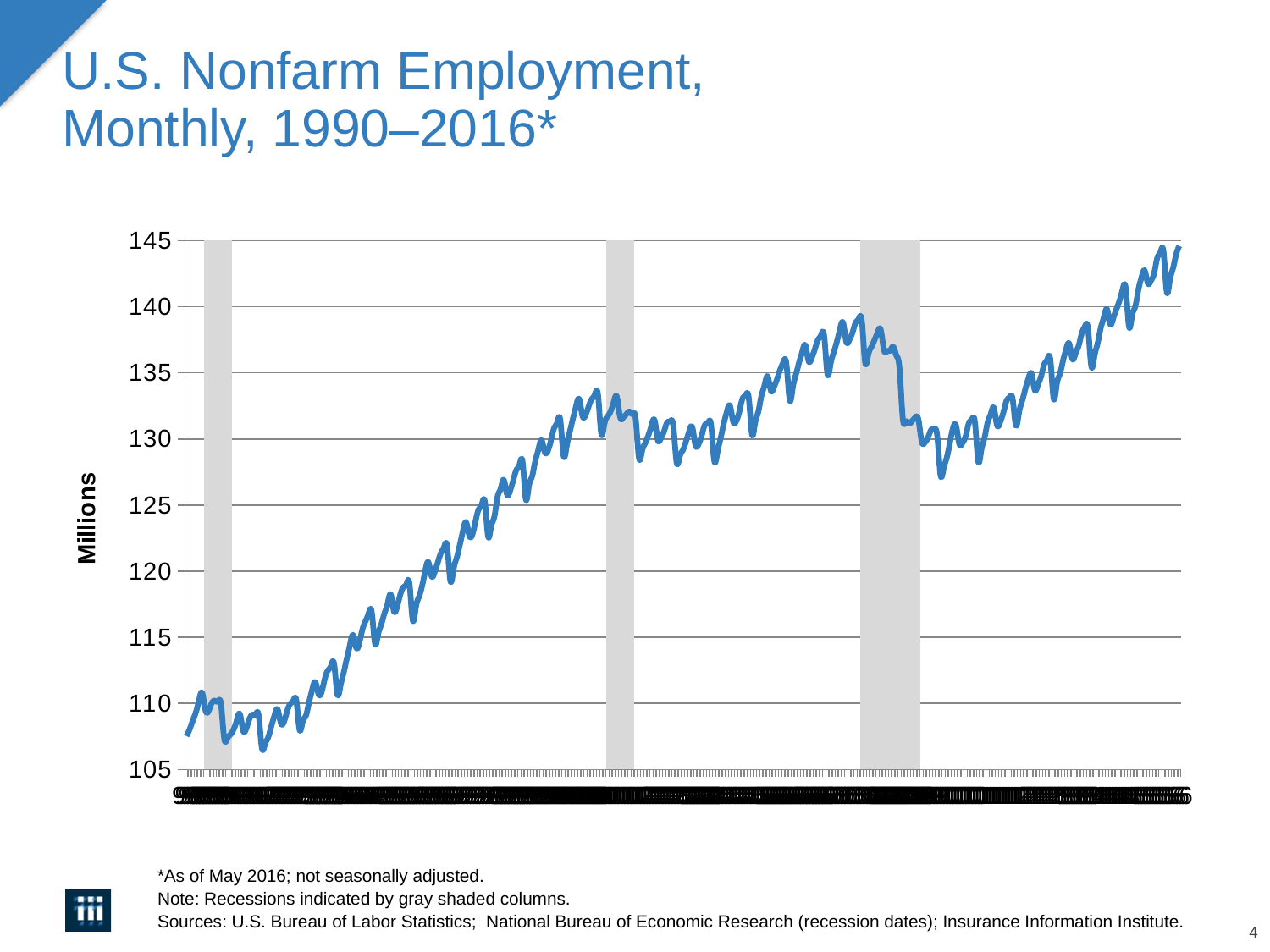
Is the highest value reached by the line greater or less than 140? greater What is the title of the chart? U.S. Nonfarm Employment, Monthly, 1990–2016* Is the lowest value reached by the line greater or less than 110? less Is the value at the bottom of the dip following the third gray shaded column greater or less than 130? less What kind of chart is shown on the slide? line chart Overall, does the line rise or fall from the left end of the x axis to the right end? rise What is the highest value shown on the vertical axis? 145 What is the label on the vertical axis of the chart? Millions Does the line rise or fall across the third (rightmost) gray shaded column? fall